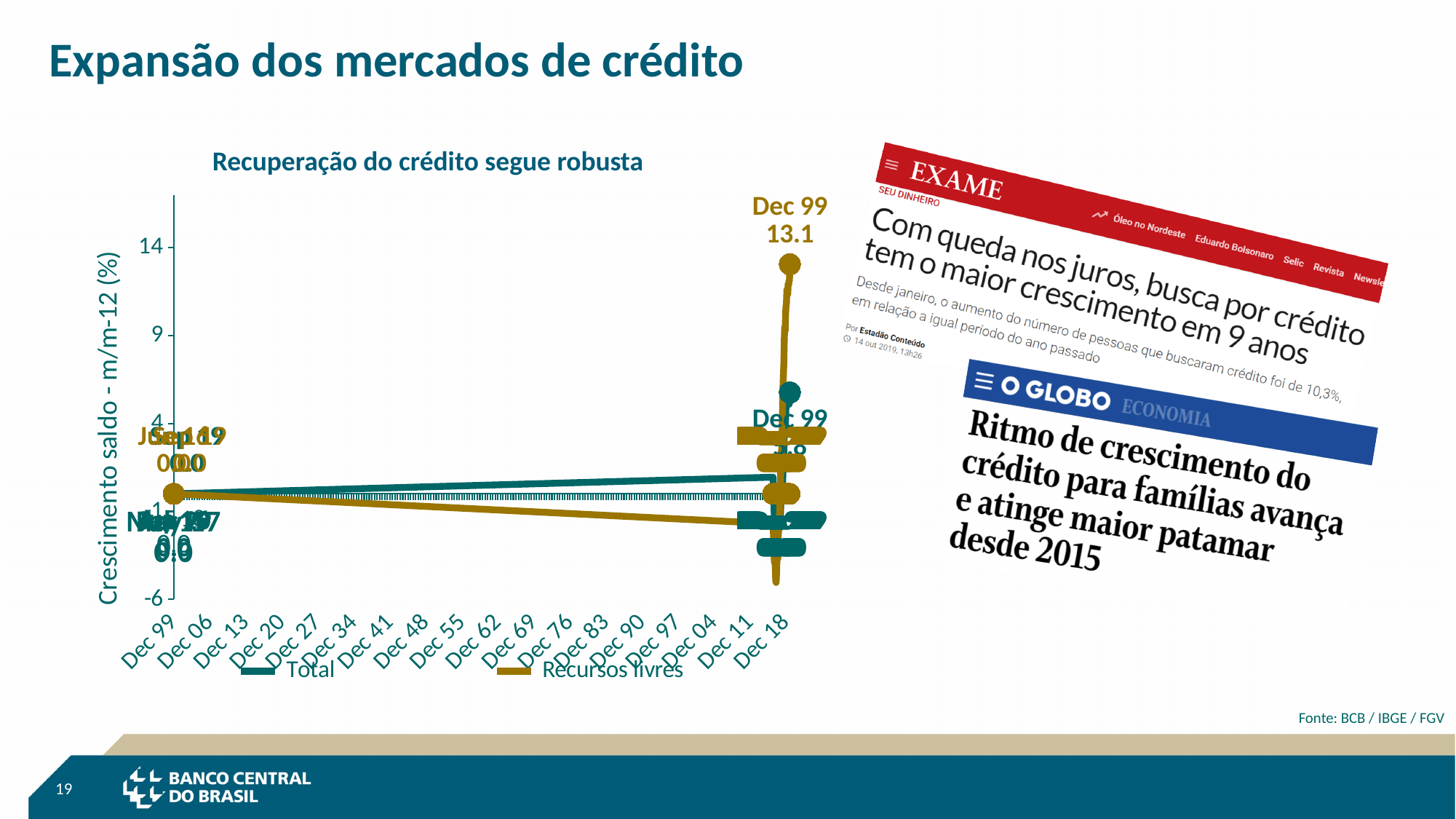
Is the highest point of the Recursos livres series greater or less than 9? greater What are the two series named in the chart legend? Total and Recursos livres How many tick labels are shown along the x axis of the chart? 18 What is the lowest value shown on the y axis of the chart? -6 What is the highest data label value shown on the chart? 13.1 What kind of chart is shown on the slide? line chart What is the value printed on the data label reading 'Dec 99' at the top of the chart? 13.1 What is the title of the chart? Recuperação do crédito segue robusta How many series does the chart legend list? 2 Which series reaches the highest point on the chart, Total or Recursos livres? Recursos livres